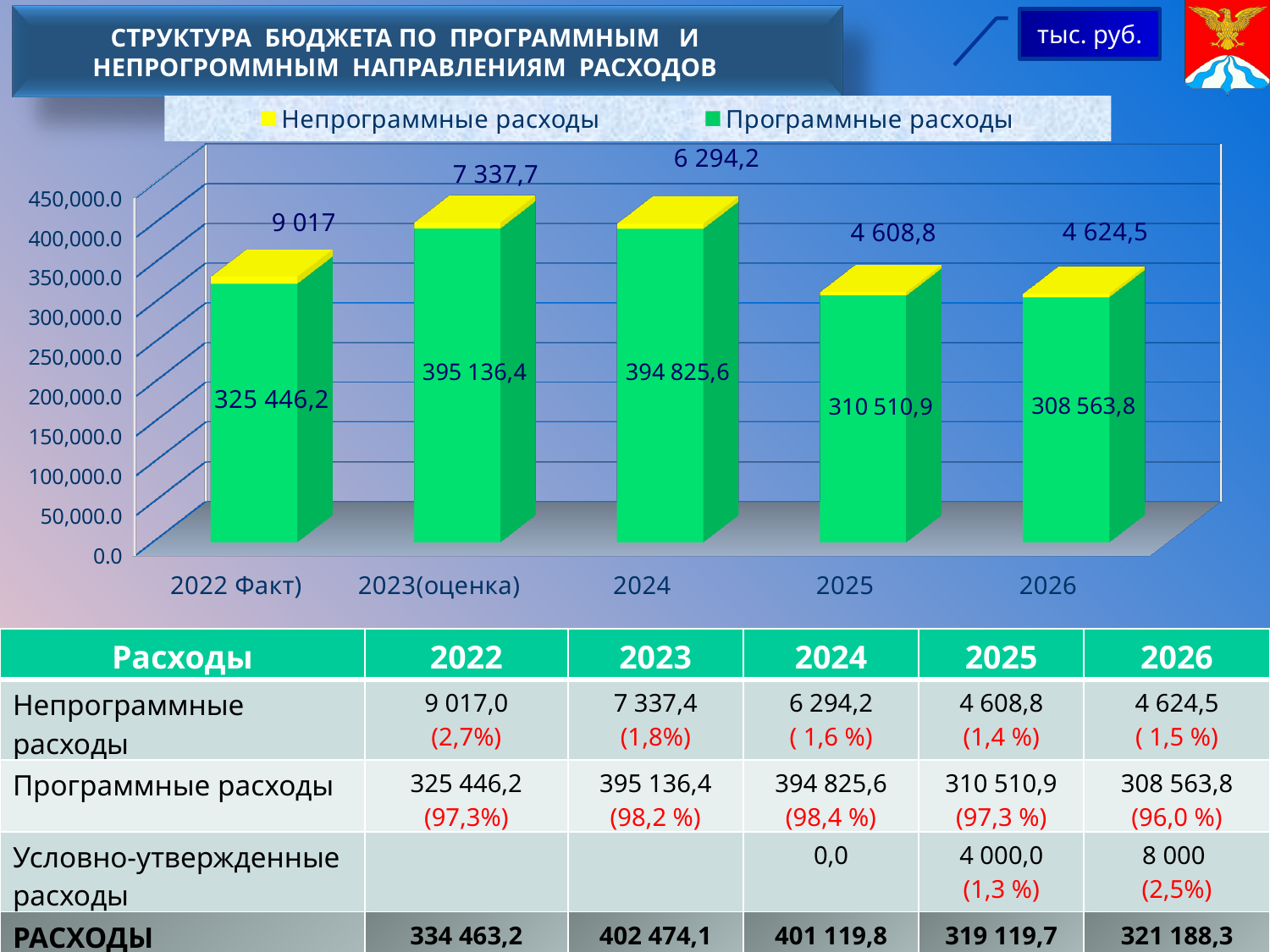
How many categories are shown along the x axis of the chart? 5 Which is larger: Непрограммные расходы in 2022 Факт) or in 2026? 2022 Факт) Is the value of Программные расходы for 2022 Факт) greater or less than 300,000.0? greater In which category is Программные расходы the highest? 2023(оценка) What is the value of Программные расходы for 2024? 394 825,6 What is the total of the stacked bar for 2024? 401 119,8 What is the difference between Программные расходы in 2023(оценка) and in 2024? 310,8 What kind of chart is shown on the slide? bar chart What is the value of Непрограммные расходы for 2025? 4 608,8 In which category is Непрограммные расходы the lowest? 2025 Which colour represents Непрограммные расходы in the chart legend? yellow How many series does the chart legend list? 2